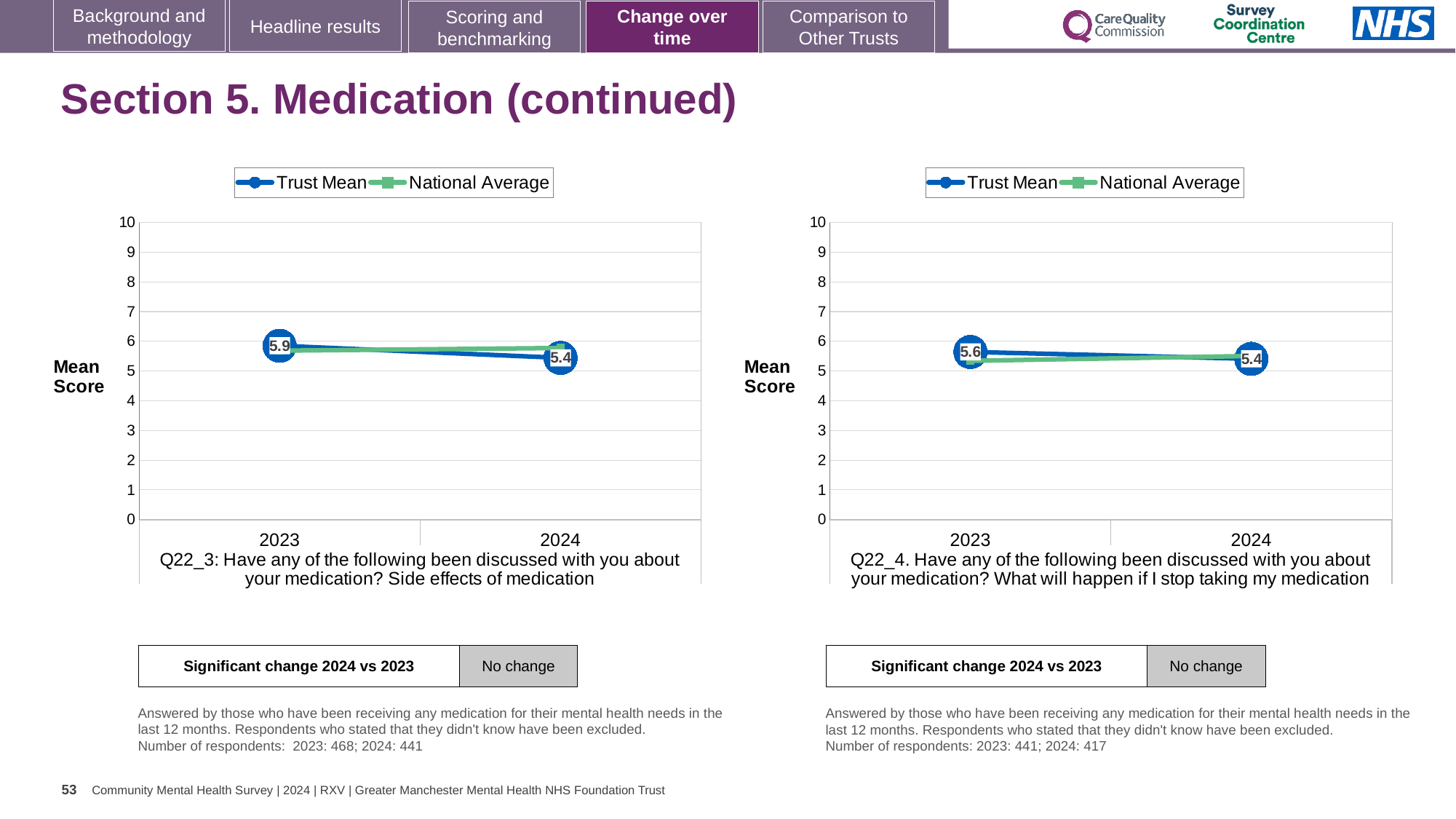
How many years are shown on the x axis of the left chart (Q22_3)? 2 In the left chart (Q22_3), what is the Trust Mean for 2024? 5.4 How many series does the legend of the right chart (Q22_4) list? 2 What type of chart is used on the left side of the slide (Q22_3)? line chart In the left chart (Q22_3), by how much did the Trust Mean change from 2023 to 2024? 0.5 In the left chart (Q22_3), what is the Trust Mean for 2023? 5.9 In the left chart (Q22_3), which year has the higher Trust Mean, 2023 or 2024? 2023 In the left chart (Q22_3), does the Trust Mean rise or fall from 2023 to 2024? fall In the right chart (Q22_4), what is the Trust Mean for 2024? 5.4 In the right chart (Q22_4), is the Trust Mean for 2023 greater or less than 5? greater In the right chart (Q22_4), what is the difference between the Trust Mean in 2023 and 2024? 0.2 In the right chart (Q22_4), what is the Trust Mean for 2023? 5.6